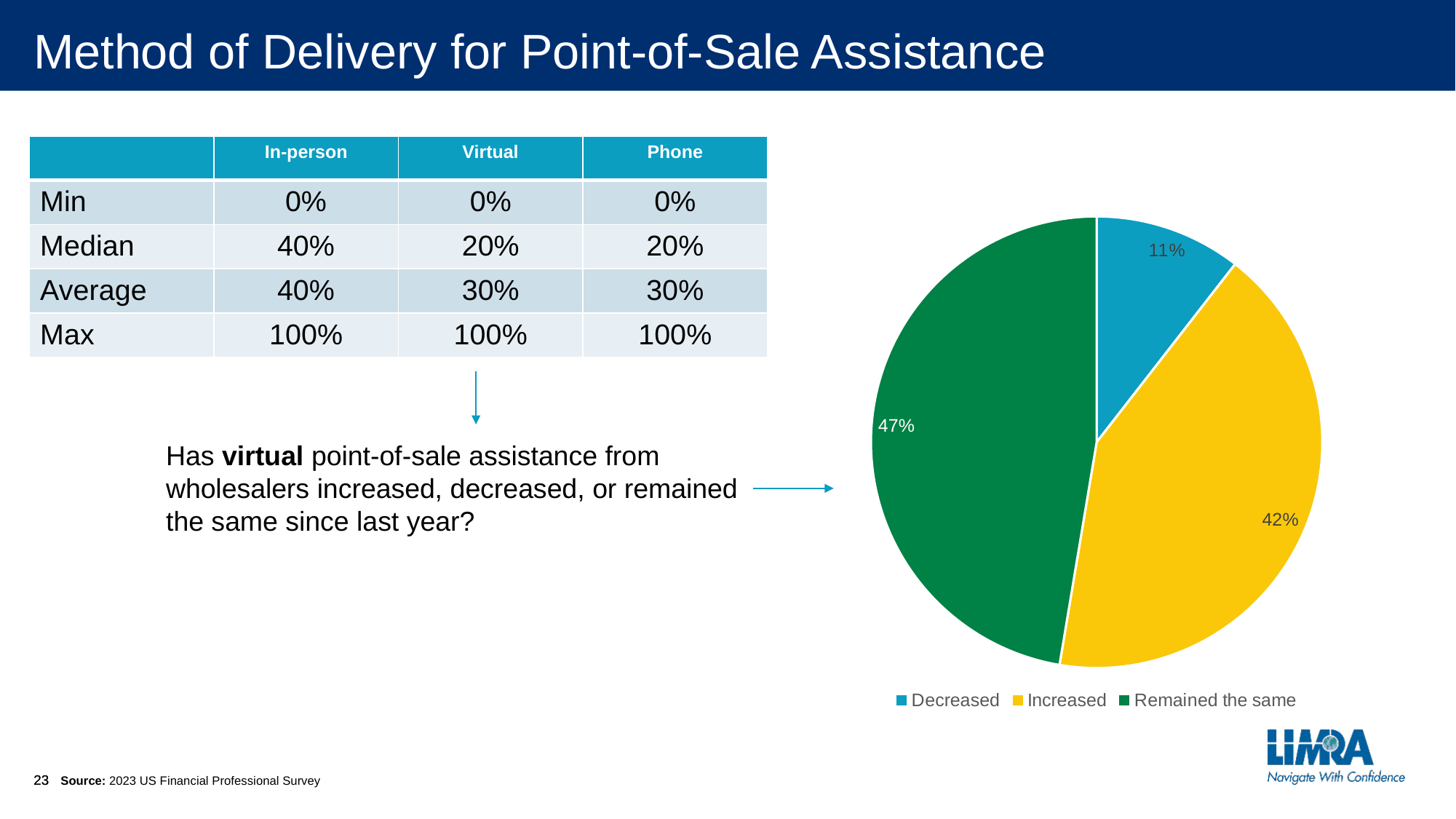
What is the difference in percentage points between the Increased slice and the Decreased slice? 31 What share of the pie chart is labelled Decreased? 11% Which slice of the pie chart is the smallest? Decreased What share of the pie chart is labelled Remained the same? 47% What kind of chart is shown on the slide? Pie chart How many slices does the pie chart have? 3 What share of the pie chart is labelled Increased? 42% What colour is the Increased slice in the pie chart? Yellow How many entries does the pie chart legend list? 3 What is the difference in percentage points between the Remained the same slice and the Increased slice? 5 Which is larger in the pie chart, Increased or Decreased? Increased Which slice of the pie chart is the largest? Remained the same